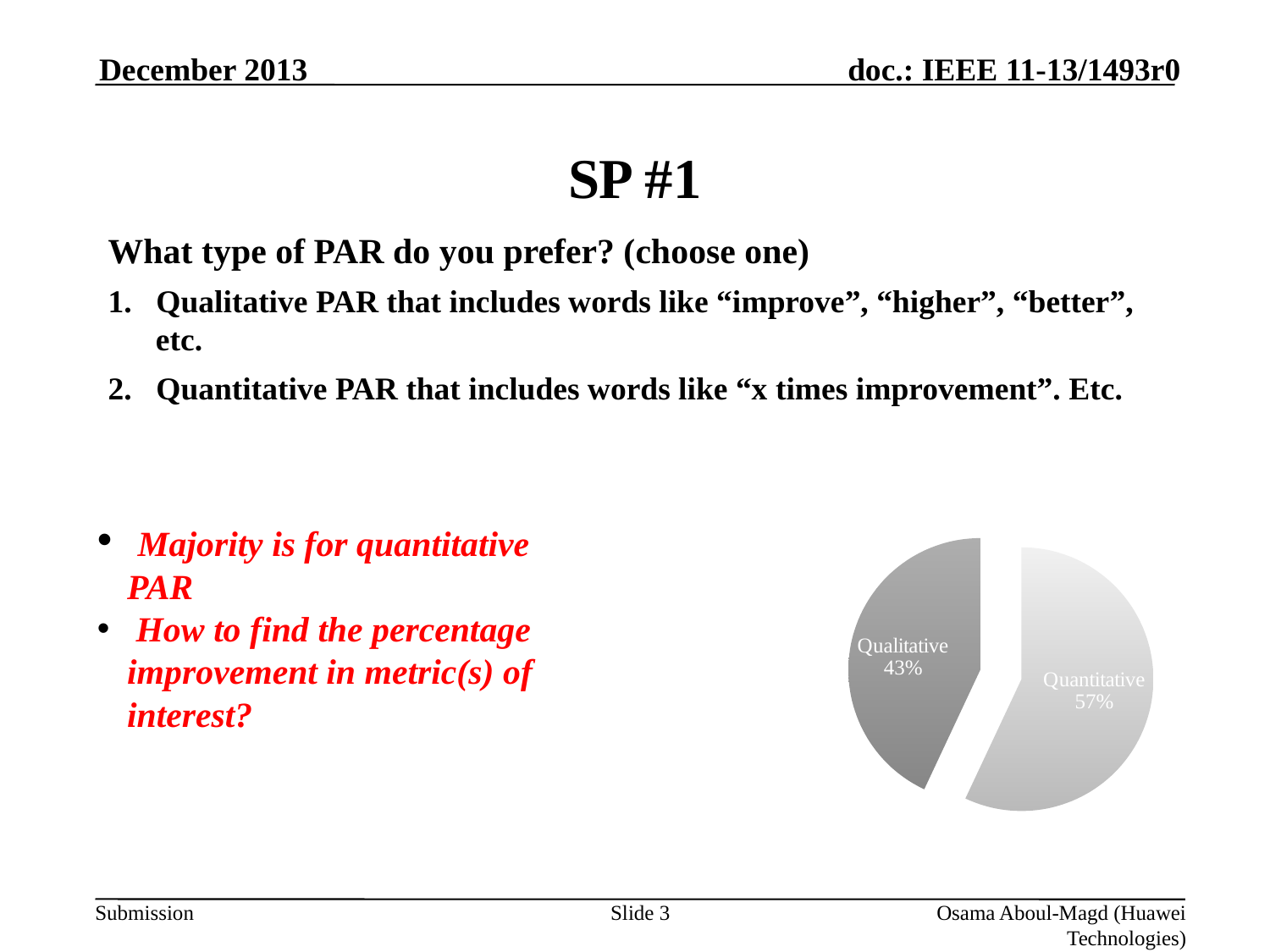
What kind of chart is shown on the slide? pie chart Which slice of the pie is the smallest? Qualitative What is the difference in percentage points between the Quantitative and Qualitative slices? 14 What are the labels of the two slices in the pie chart? Qualitative and Quantitative How many slices does the pie chart have? 2 Is the Qualitative share greater or less than 50%? less Is the Quantitative share greater or less than 50%? greater Which slice of the pie is the largest? Quantitative What share of the pie does Quantitative represent? 57% What share of the pie does Qualitative represent? 43% Which is larger, the Qualitative slice or the Quantitative slice? Quantitative